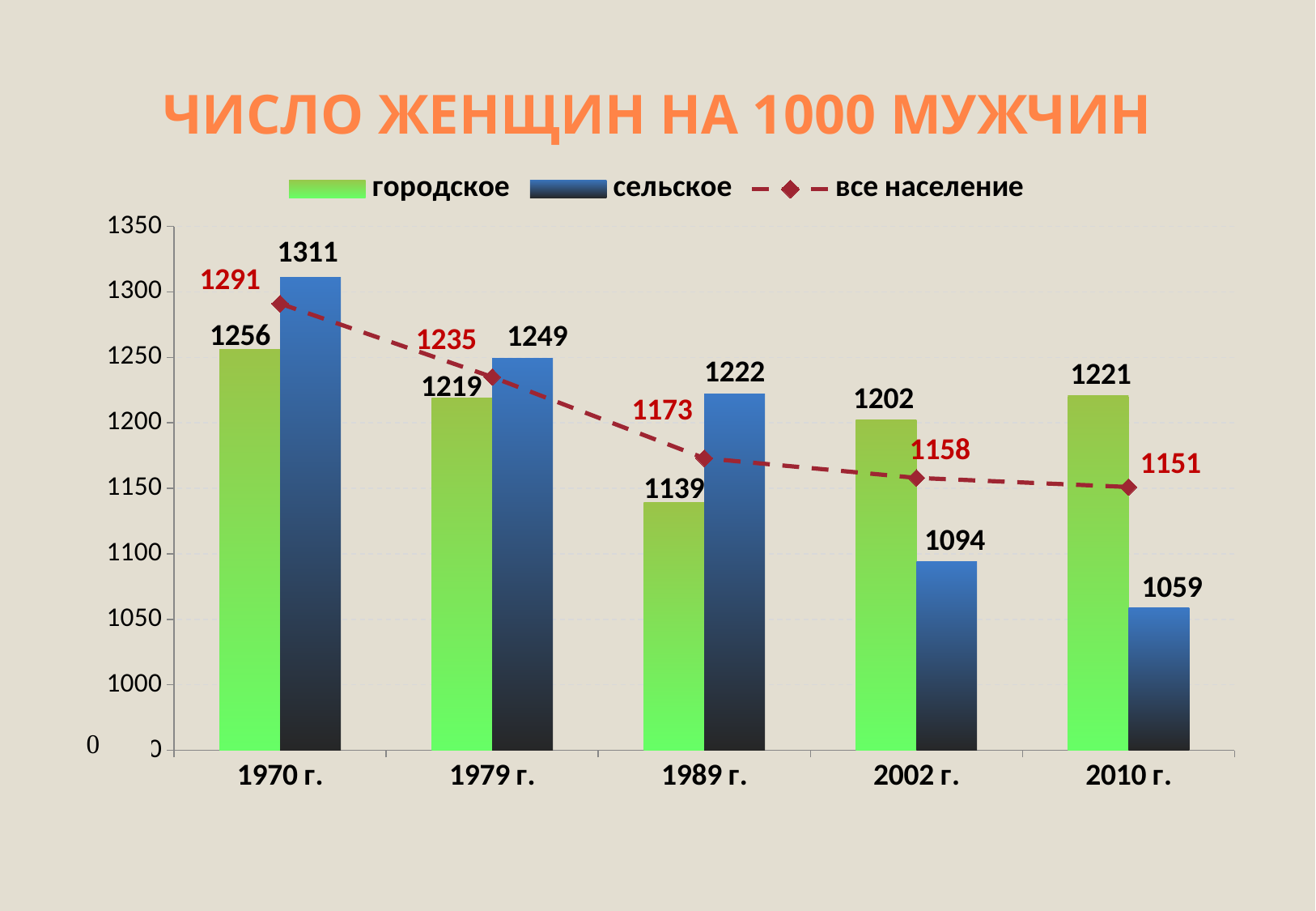
In which year is the сельское value lowest? 2010 г. What is the value for сельское in 1970 г.? 1311 What kind of chart is this? Bar chart with a line What is the value of все население in 2002 г.? 1158 Does the все население line rise or fall from 1970 г. to 2010 г.? Fall What is the title of the chart? ЧИСЛО ЖЕНЩИН НА 1000 МУЖЧИН What is the difference between the сельское and городское values in 2010 г.? 162 What is the value for городское in 1989 г.? 1139 How many series does the legend list? 3 In which year is the городское value highest? 1970 г. How many years are shown on the x axis? 5 Which is larger in 2002 г., городское or сельское? городское